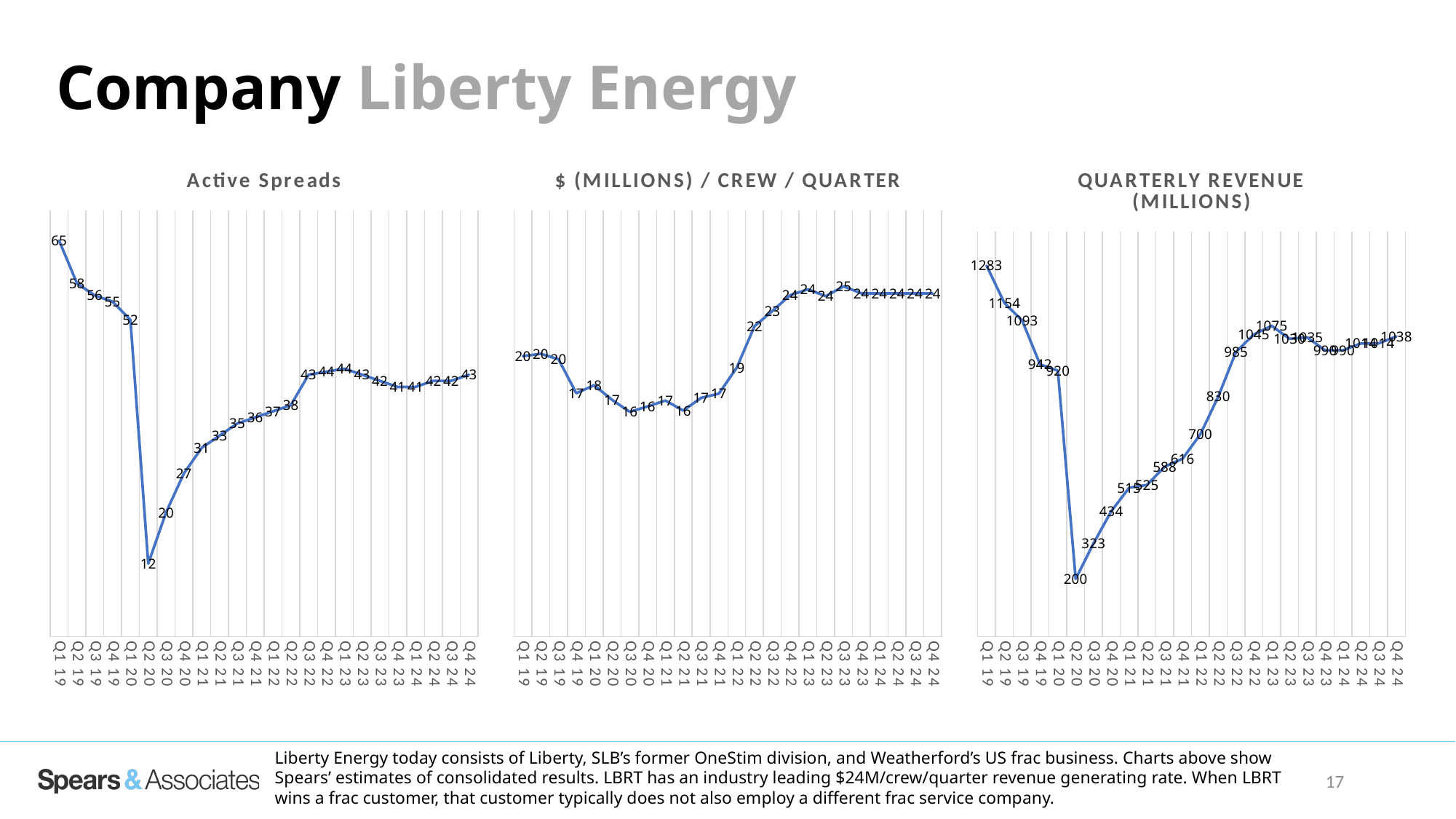
On the Quarterly Revenue (Millions) chart, what is the value for Q2 20? 200 On the Quarterly Revenue (Millions) chart, which quarter has the highest revenue? Q1 19 On the Active Spreads chart, which quarter has the lowest value? Q2 20 On the Active Spreads chart, what is the value for Q1 19? 65 On the Active Spreads chart, what is the difference between the Q1 19 value and the Q2 20 value? 53 On the Active Spreads chart, which quarter has the highest value? Q1 19 On the Quarterly Revenue (Millions) chart, what is the value for Q1 23? 1075 How many quarters are plotted on the Active Spreads chart? 24 On the $ (Millions) / Crew / Quarter chart, do values rise or fall from Q1 22 to Q3 23? rise On the Quarterly Revenue (Millions) chart, what is the difference between the Q1 19 value and the Q2 20 value? 1083 On the $ (Millions) / Crew / Quarter chart, which quarter has the highest value? Q3 23 What kind of chart is the Quarterly Revenue (Millions) chart? line chart